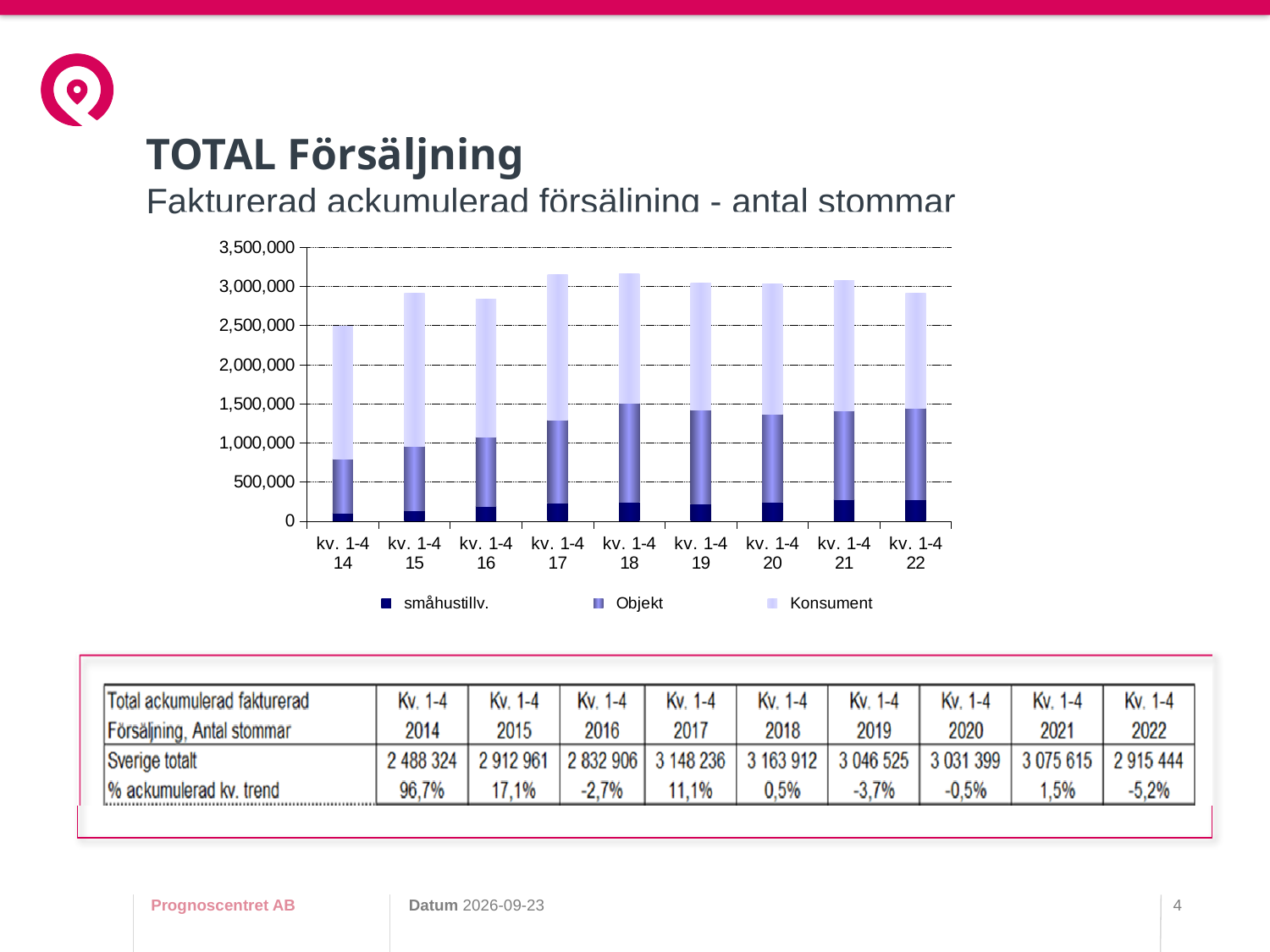
Is the total stacked value for kv. 1-4 14 greater or less than 3,000,000? less How many series does the chart legend list? 3 Is the total stacked value for kv. 1-4 17 greater or less than 3,000,000? greater How many categories (quarters) are shown on the x axis of the chart? 9 Which has the larger total stacked bar, kv. 1-4 14 or kv. 1-4 15? kv. 1-4 15 Is the top of the Objekt segment for kv. 1-4 14 greater or less than 1,000,000? less Which quarter has the lowest total stacked bar? kv. 1-4 14 Do the total stacked bars rise or fall from kv. 1-4 14 to kv. 1-4 17? rise According to the table below the chart, what is the % ackumulerad kv. trend for Kv. 1-4 2014? 96,7% What are the three series named in the chart legend? småhustillv., Objekt, Konsument What kind of chart is shown on the slide? bar chart According to the table below the chart, what is the Sverige totalt value for Kv. 1-4 2022? 2 915 444